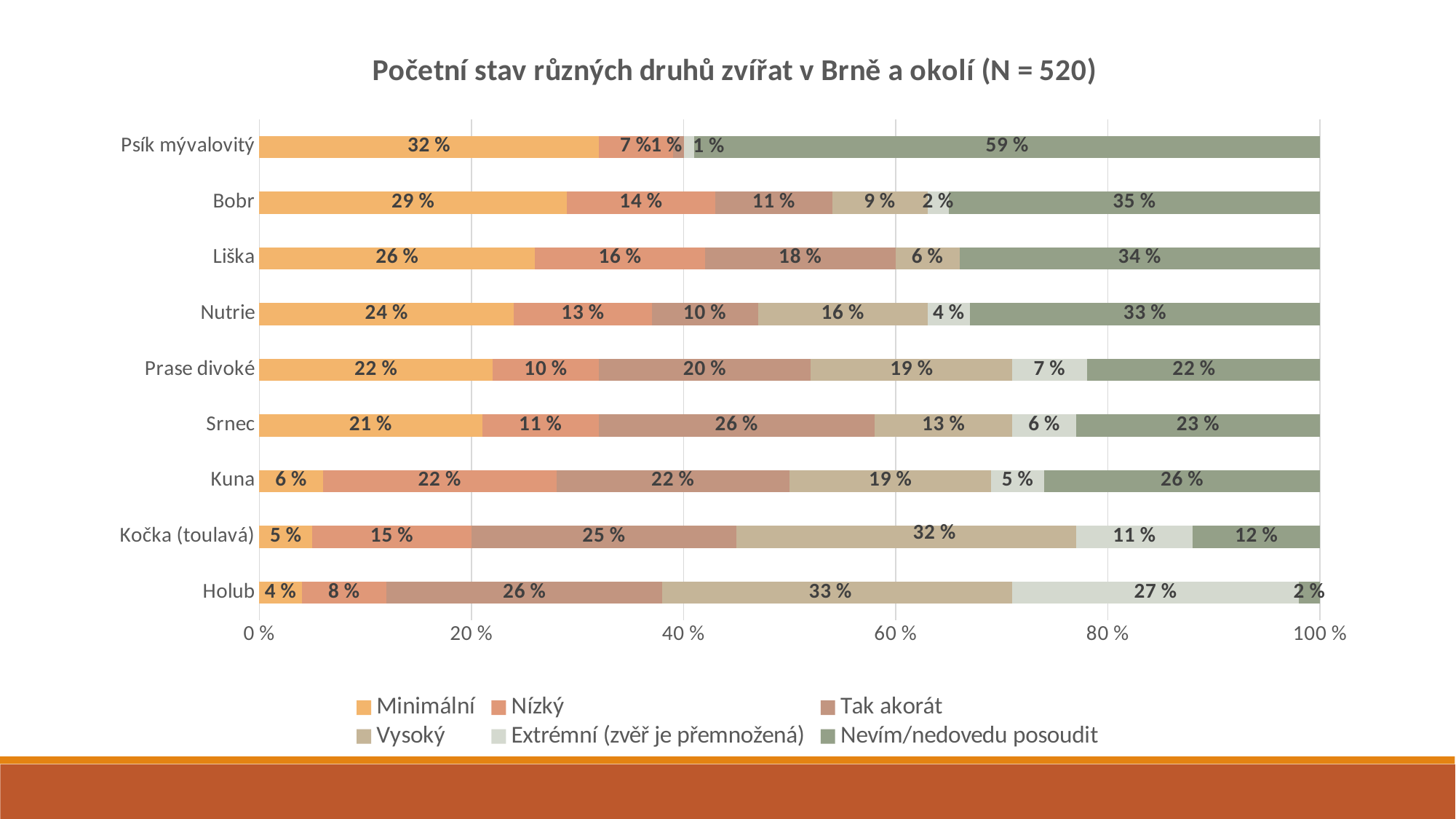
Which animal has the highest "Nevím/nedovedu posoudit" share? Psík mývalovitý What is the "Nevím/nedovedu posoudit" value for Bobr? 35 % Which is larger: the "Nízký" value for Kuna or the "Nízký" value for Nutrie? Kuna What is the sample size (N) stated in the chart title? 520 How many series does the legend list? 6 Which animal has the lowest "Minimální" share? Holub What kind of chart is shown on the slide? Stacked bar chart What is the difference between the "Tak akorát" values for Srnec and Liška? 8 % What is the "Vysoký" value for Holub? 33 % What is the "Extrémní (zvěř je přemnožená)" value for Kočka (toulavá)? 11 % How many animal categories are shown on the chart? 9 What percentage of respondents answered "Minimální" for Psík mývalovitý? 32 %